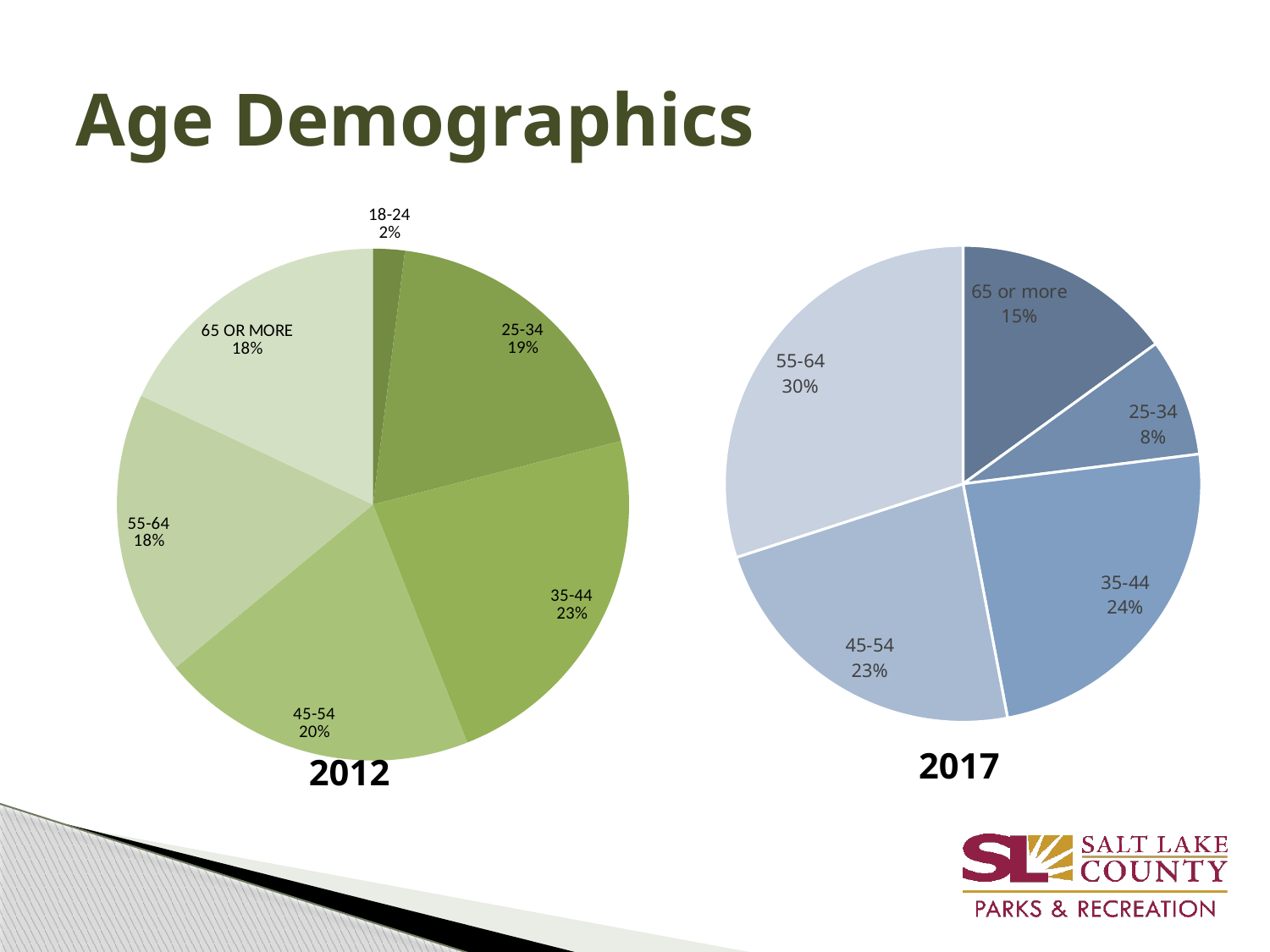
In the 2017 pie chart, what share is the 25-34 age group? 8% In the 2012 pie chart, what share is the 35-44 age group? 23% In the 2017 pie chart, what share is the 55-64 age group? 30% In the 2012 pie chart, what share is the 18-24 age group? 2% In the 2017 pie chart, which age group has the largest share? 55-64 How many age groups are shown in the 2017 pie chart? 5 In the 2012 pie chart, which age group has the largest share? 35-44 In the 2017 pie chart, which age group has the smallest share? 25-34 In the 2012 pie chart, which age group has the smallest share? 18-24 What is the difference between the 55-64 share in the 2017 chart and the 55-64 share in the 2012 chart? 12 percentage points In the 2012 pie chart, which is larger: the 45-54 share or the 25-34 share? 45-54 What type of chart is used for the 2012 data? Pie chart